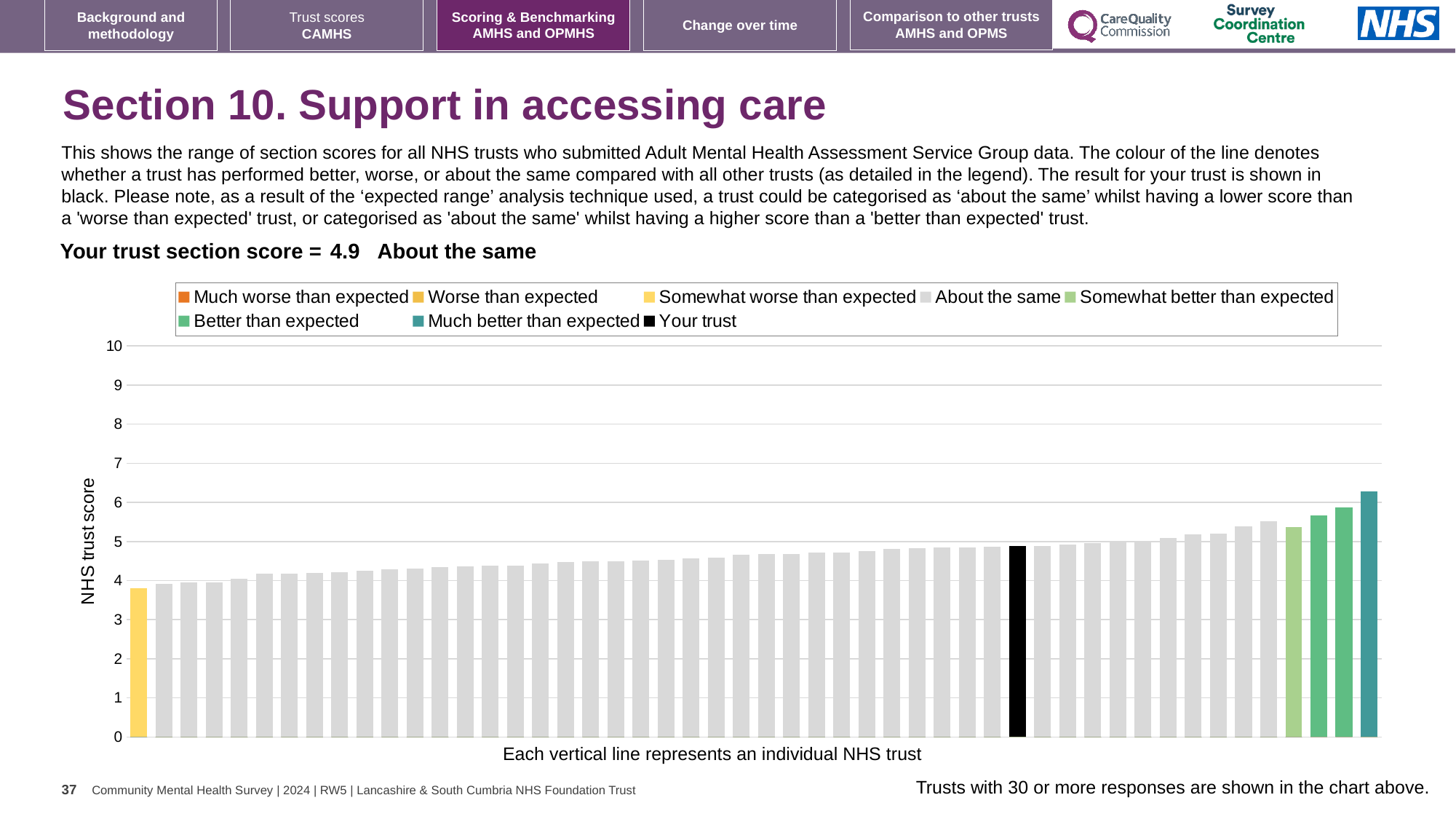
What is the highest value shown on the vertical axis? 10 Which category is your trust placed in for this section? About the same What is the label of the vertical axis? NHS trust score What kind of chart is shown on the slide? bar chart Which legend category does the tallest bar belong to? Much better than expected How many entries does the chart legend list? 8 Is the value of the black 'Your trust' bar greater or less than 4? greater What is the section score for your trust? 4.9 Do the bar values rise or fall from left to right along the x axis? rise Is the value of the shortest bar greater or less than 4? less Is the value of the tallest bar greater or less than 6? greater What colour is the bar representing your trust? black